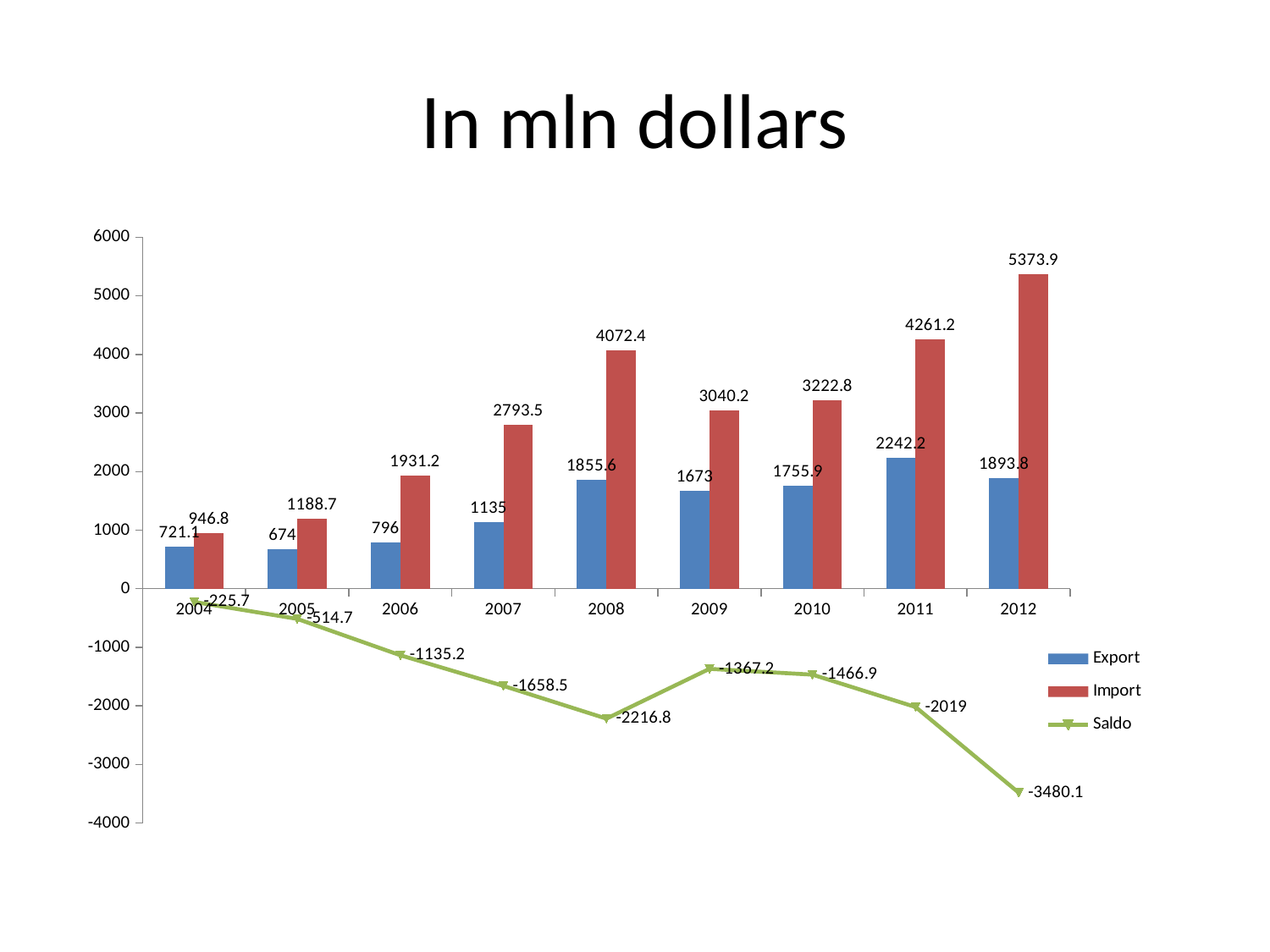
What is the title of the chart? In mln dollars Does the Import series rise or fall from 2004 to 2012? rise How many years are shown on the x axis? 9 How many series does the legend list? 3 What is the difference between Import and Export in 2010? 1466.9 Which year has the highest Export value? 2011 Which is larger, the Export value in 2008 or the Export value in 2009? Export in 2008 What is the Saldo value for 2008? -2216.8 What is the Import value for 2012? 5373.9 Is the Import value for 2009 greater or less than 3000? greater What is the Export value for 2007? 1135 Which year has the lowest Import value? 2004